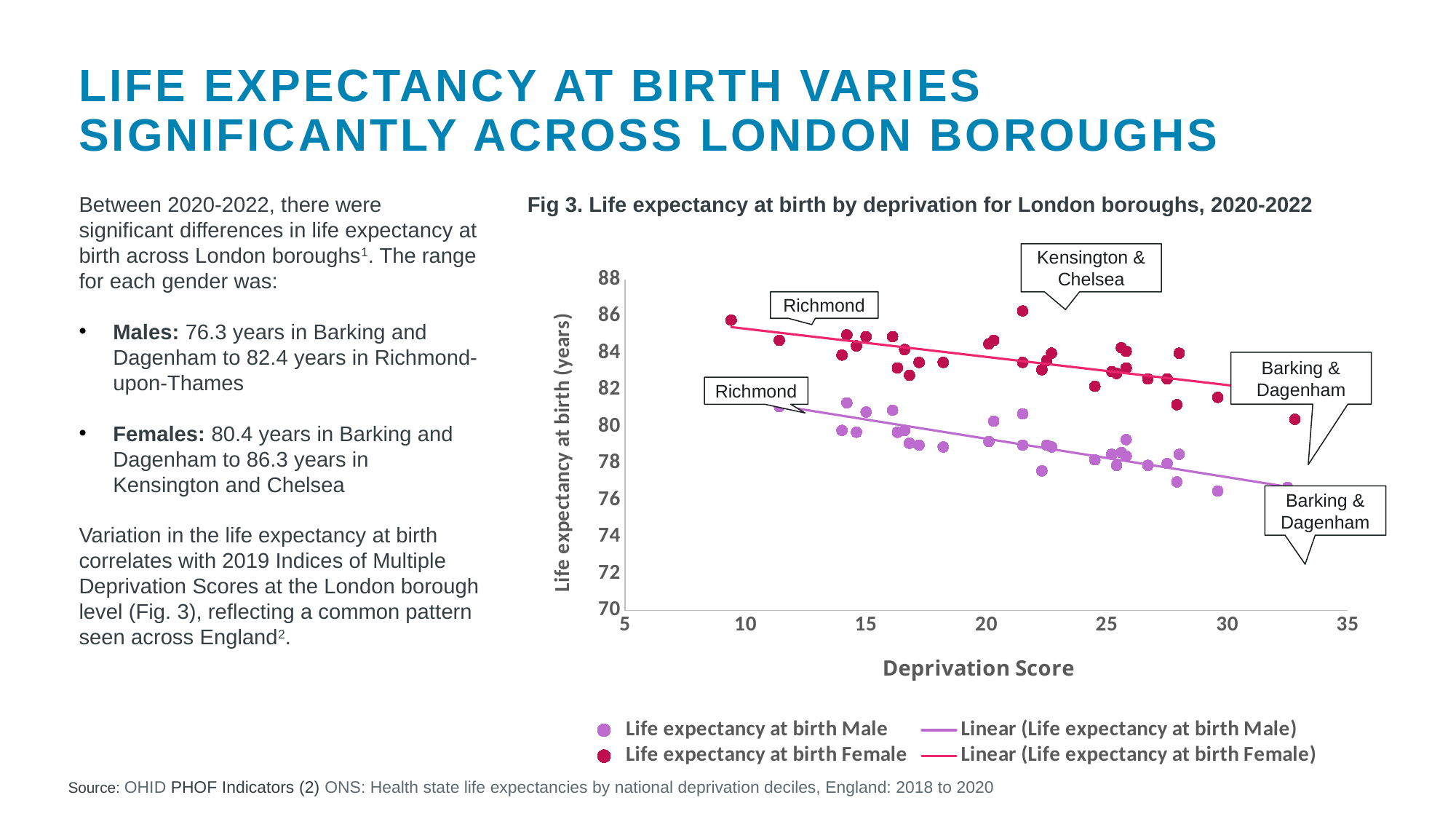
In Fig 3, do life expectancy values rise or fall as the deprivation score increases? Fall In Fig 3, is the male life expectancy for Richmond greater or less than 84? less In Fig 3, which is higher for Barking & Dagenham: the female or the male life expectancy at birth? Female How many entries does the legend of Fig 3 list? 4 In Fig 3, is the female life expectancy for Kensington & Chelsea greater or less than 84? greater In Fig 3, is the male life expectancy for Barking & Dagenham greater or less than 78? less What is the label of the x axis in Fig 3? Deprivation Score Which borough has the lowest male life expectancy at birth in Fig 3? Barking & Dagenham What kind of chart is shown in Fig 3? Scatter chart What is the title of the chart on the slide? Fig 3. Life expectancy at birth by deprivation for London boroughs, 2020-2022 Which borough has the highest female life expectancy at birth in Fig 3? Kensington & Chelsea